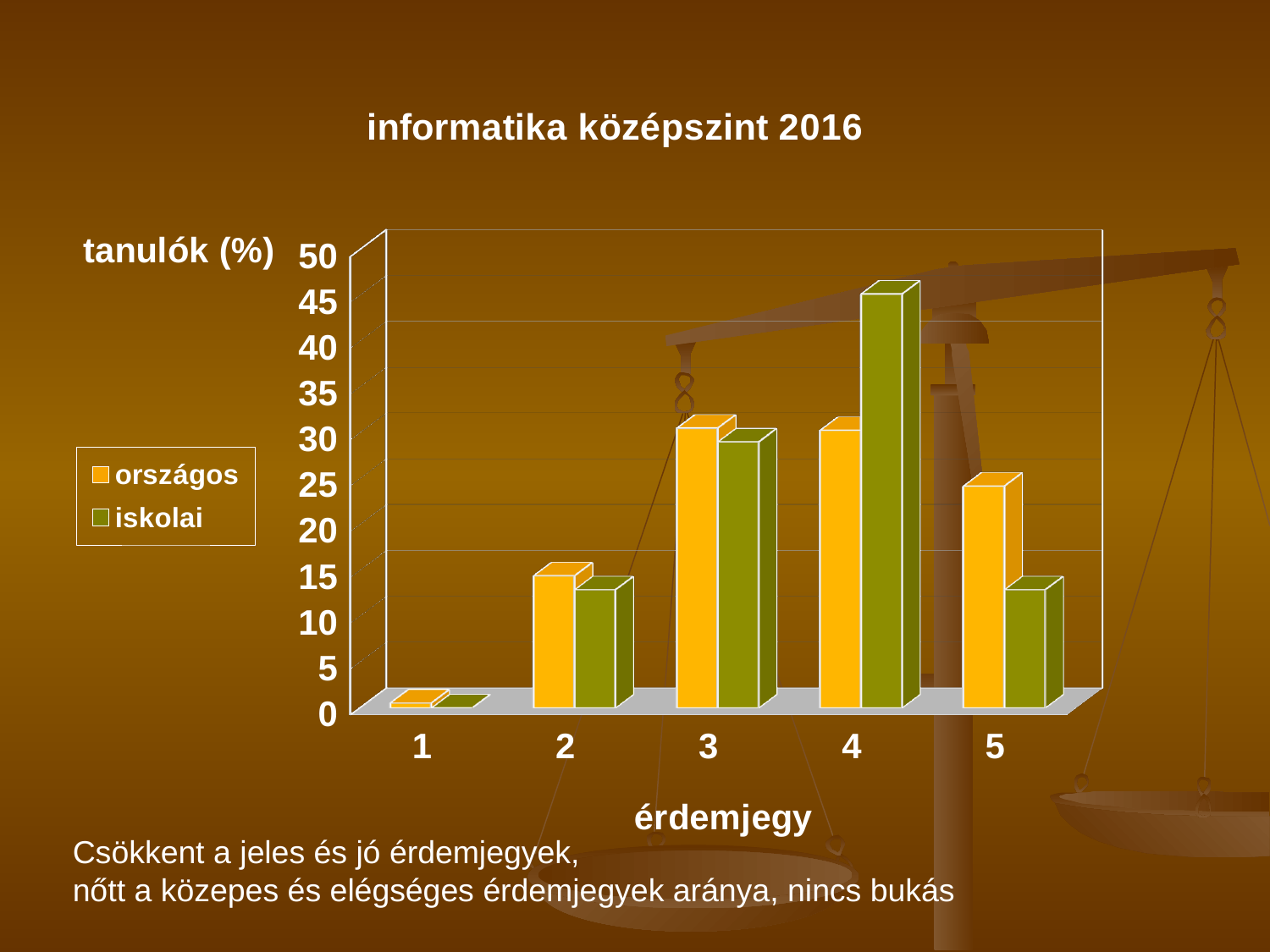
Is the országos value for grade 3 greater or less than 25? greater How many series does the legend list? 2 How many grade categories (érdemjegy) are shown on the x axis? 5 What is the title of the chart? informatika középszint 2016 What is the label of the vertical axis? tanulók (%) For which grade is the országos value the lowest? 1 For which grade is the iskolai value the lowest? 1 For which grade is the iskolai value the highest? 4 For grade 5, which series has the larger value, országos or iskolai? országos Is the országos value for grade 2 greater or less than 20? less Is the iskolai value for grade 4 greater or less than 40? greater What kind of chart is shown on the slide? bar chart